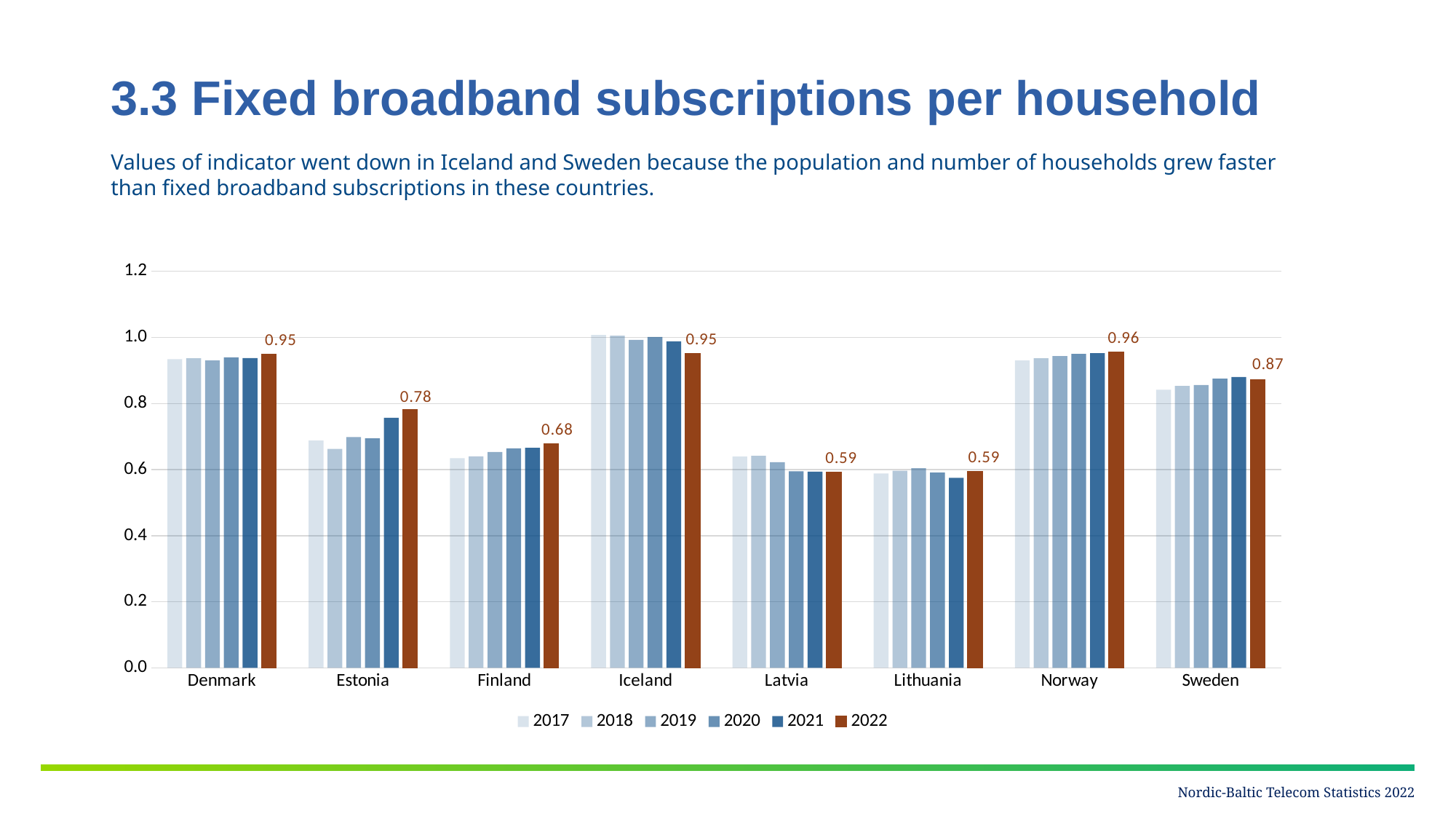
Is the 2017 value for Estonia greater or less than 0.8? less What type of chart is shown on the slide? bar chart Which year is shown in the brown (dark orange) bars according to the legend? 2022 What is the 2022 value for Sweden? 0.87 Which is larger, the 2022 value for Estonia or the 2022 value for Finland? Estonia Which country has the highest 2022 value? Norway Do the values for Iceland rise or fall from 2017 to 2022? fall What is the 2022 value for Finland? 0.68 How many countries are shown on the x axis of the chart? 8 What is the difference between the 2022 values for Norway and Sweden? 0.09 How many series does the chart legend list? 6 What is the 2022 value for Estonia? 0.78